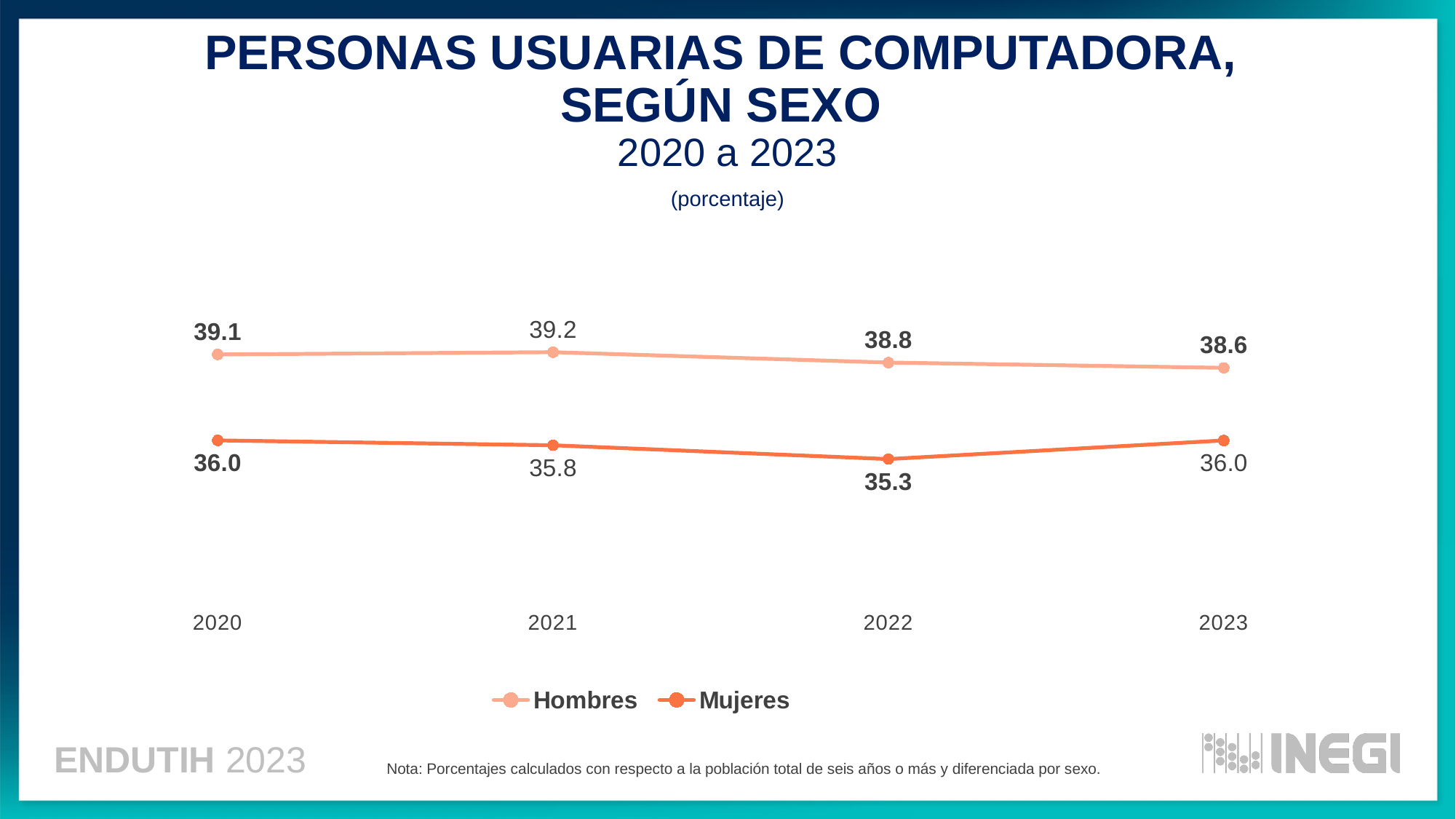
Does the Hombres series rise or fall from 2021 to 2023? Fall How many series does the legend list? 2 What is the difference between the Mujeres values in 2023 and 2022? 0.7 In which year is the Mujeres value lowest? 2022 How many years are shown on the x axis? 4 What is the value for Hombres in 2023? 38.6 What is the value for Hombres in 2021? 39.2 What is the value for Mujeres in 2022? 35.3 Which series has the larger value in 2022, Hombres or Mujeres? Hombres What kind of chart is shown on the slide? Line chart What is the difference between the Hombres and Mujeres values in 2020? 3.1 In which year is the Hombres value highest? 2021